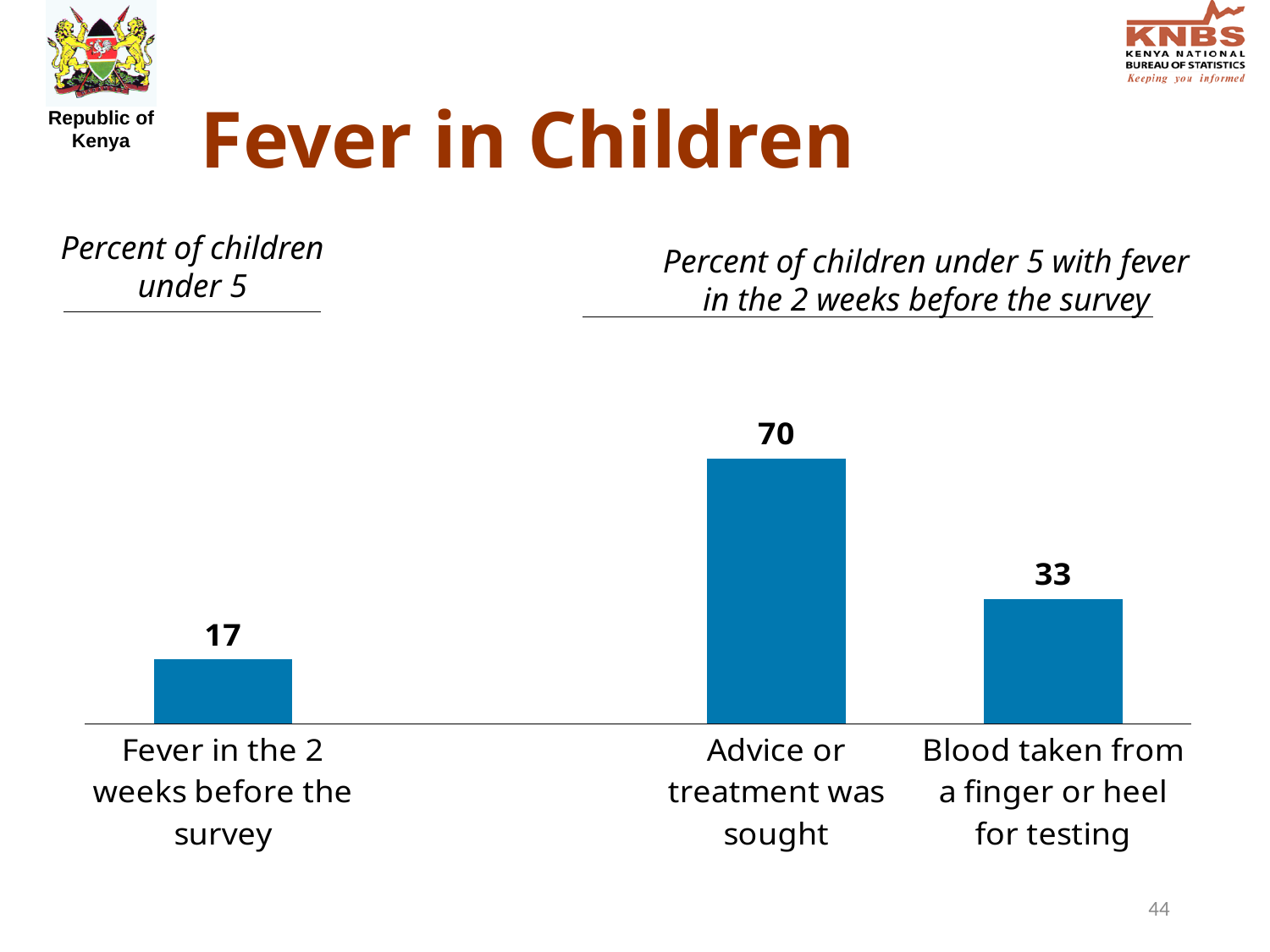
Which category has the highest value? Advice or treatment was sought Which is larger: the value for 'Blood taken from a finger or heel for testing' or the value for 'Fever in the 2 weeks before the survey'? Blood taken from a finger or heel for testing How many bars are shown in the chart? 3 What colour are the bars in the chart? Blue What is the difference between the values for 'Advice or treatment was sought' and 'Blood taken from a finger or heel for testing'? 37 What is the value for 'Blood taken from a finger or heel for testing'? 33 What is the value for 'Advice or treatment was sought'? 70 What is the value for 'Fever in the 2 weeks before the survey'? 17 Which category has the lowest value? Fever in the 2 weeks before the survey What is the difference between the values for 'Blood taken from a finger or heel for testing' and 'Fever in the 2 weeks before the survey'? 16 What is the title of the slide? Fever in Children What kind of chart is shown on the slide? Bar chart